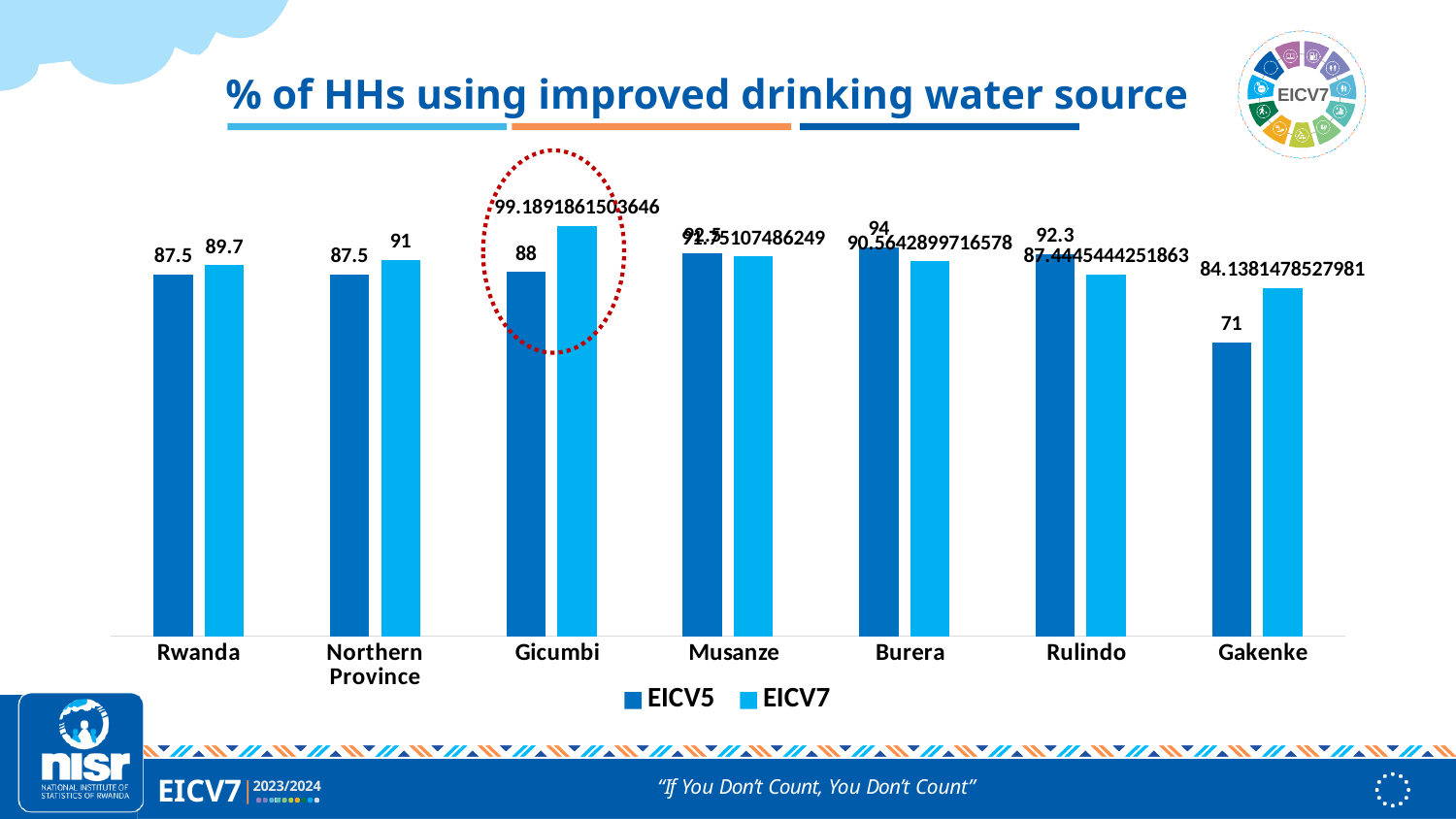
What is the EICV5 value for Gakenke? 71 Which category has the lowest EICV5 value? Gakenke Which category has the highest EICV7 value? Gicumbi How many categories are shown on the x axis? 7 What is the EICV7 value for Northern Province? 91 For Burera, which is larger: the EICV5 value or the EICV7 value? EICV5 What is the EICV5 value for Burera? 94 What is the EICV5 value for Rwanda? 87.5 What type of chart is shown on the slide? Bar chart What is the difference between the EICV7 and EICV5 values for Rwanda? 2.2 How many series does the legend list? 2 What is the EICV5 value for Gicumbi? 88